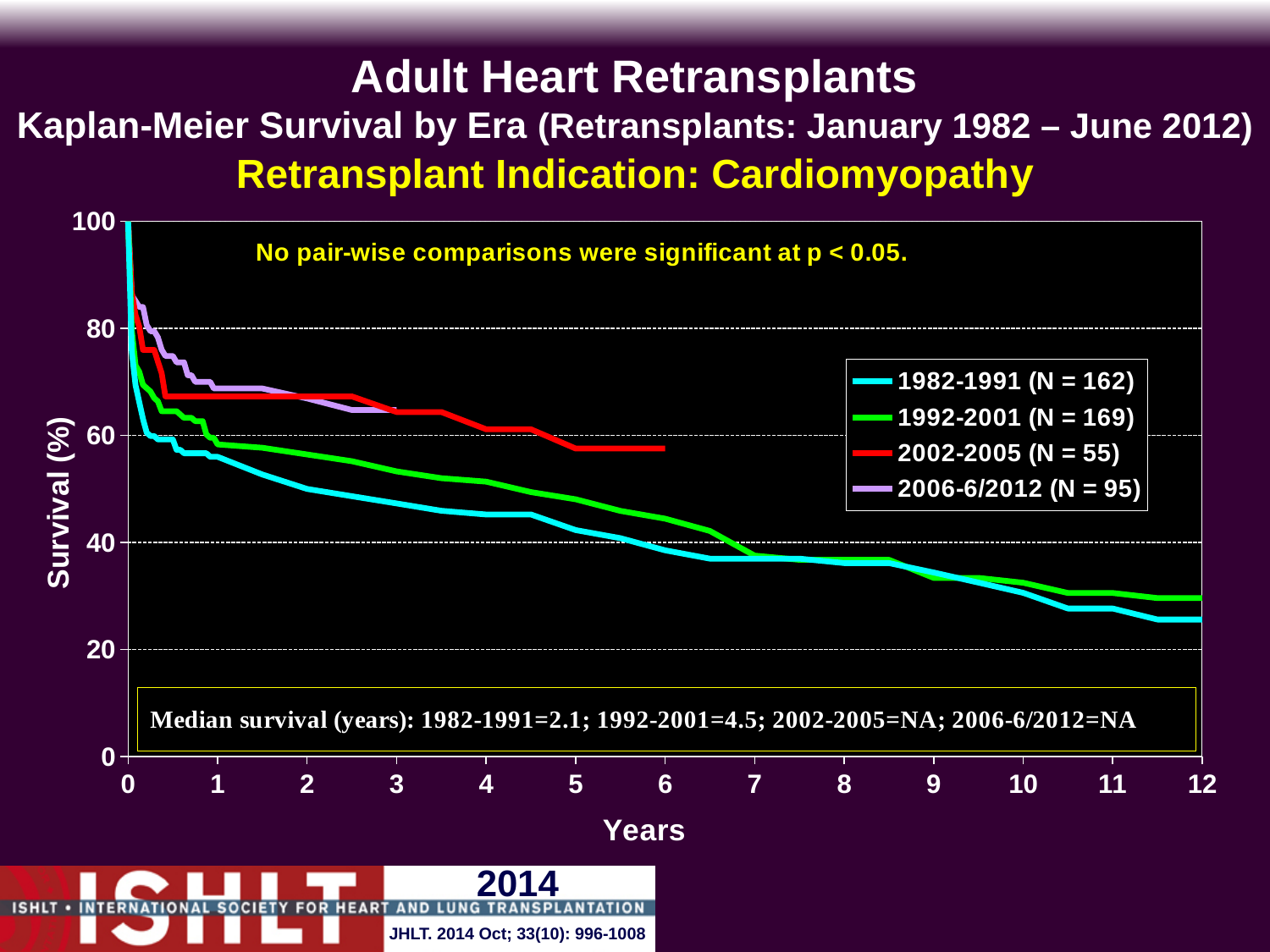
Is the survival value for the 1982-1991 era at 12 years greater or less than 40? less What is the N for the 2006-6/2012 era shown in the legend? 95 Which era has the smallest N in the legend? 2002-2005 (N = 55) Do the survival curves rise or fall as years increase? fall Is the survival value for the 2006-6/2012 era at 3 years greater or less than 60? greater How many series does the legend list? 4 Which era has the largest N in the legend? 1992-2001 (N = 169) What kind of chart is shown on the slide? line chart At 4 years, which era has higher survival: 2002-2005 or 1982-1991? 2002-2005 What is the median survival in years for the 1982-1991 era? 2.1 What is the median survival in years for the 1992-2001 era? 4.5 What is the median survival listed for the 2002-2005 era? NA